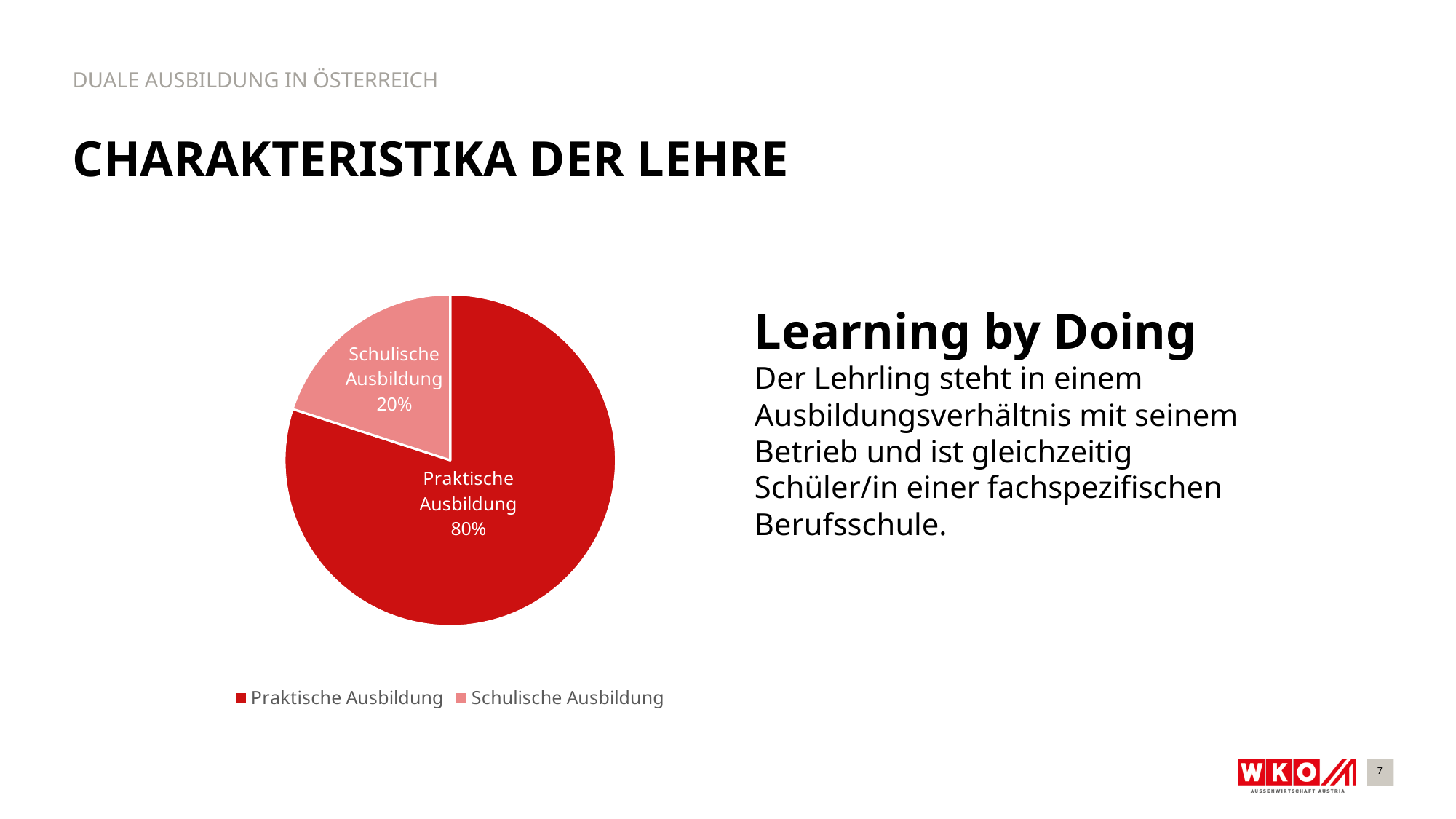
What kind of chart is shown on the slide? pie chart What is the difference in percentage points between Praktische Ausbildung and Schulische Ausbildung? 60 How many entries does the legend list? 2 What share of the pie does Praktische Ausbildung have? 80% Which slice of the pie is the smallest? Schulische Ausbildung What share of the pie does Schulische Ausbildung have? 20% Where is the legend positioned relative to the pie chart? below the chart Which is larger, Praktische Ausbildung or Schulische Ausbildung? Praktische Ausbildung Which slice of the pie is the largest? Praktische Ausbildung How many slices does the pie chart have? 2 What colour is the Schulische Ausbildung slice? light red (pink)